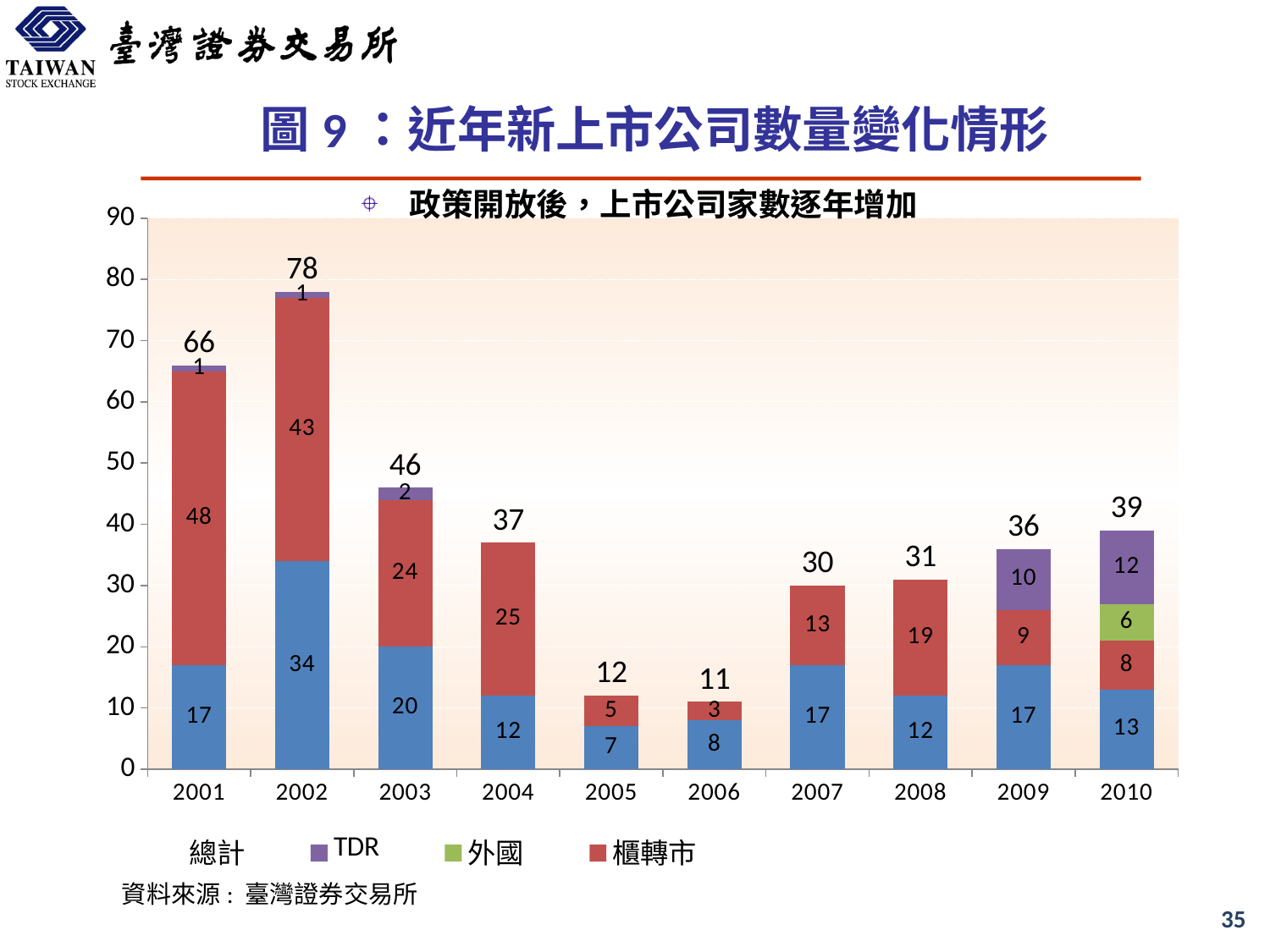
What is the TDR value for 2010? 12 Which year has the highest total (總計) of new listed companies? 2002 What is the total of the stacked bar for 2009? 36 How many years are shown on the x axis of the chart? 10 How many entries does the legend list? 4 What is the difference between the total for 2002 and the total for 2001? 12 Which year has the larger 櫃轉市 value, 2007 or 2008? 2008 Is the total for 2003 greater or less than 40? greater What kind of chart is shown on the slide? stacked bar chart What is the 櫃轉市 value for 2004? 25 What is the 外國 value for 2010? 6 Which year has the lowest total (總計) of new listed companies? 2006